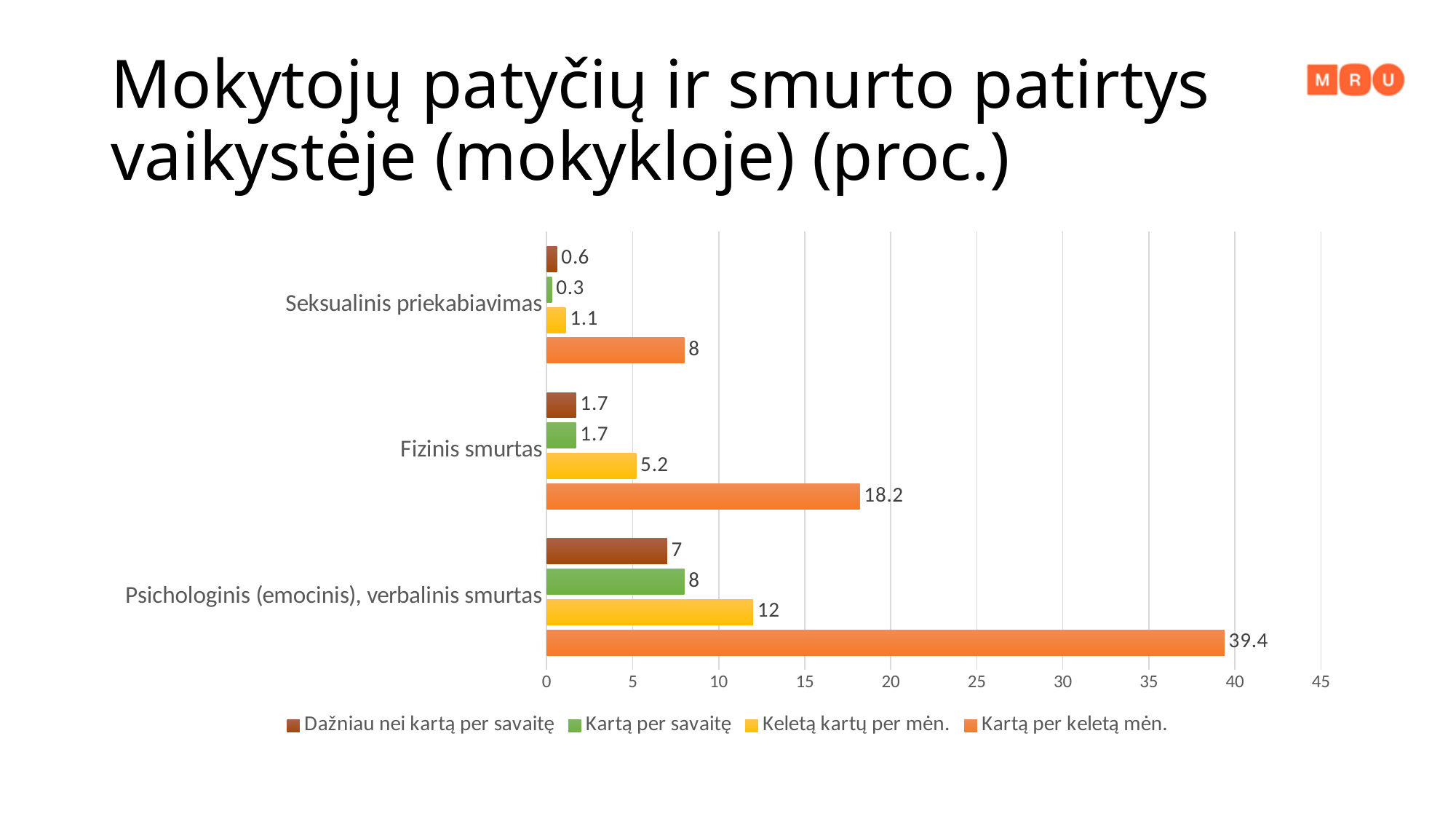
What kind of chart is shown on the slide? bar chart Which is larger: the "Keletą kartų per mėn." value for "Fizinis smurtas" or the "Kartą per keletą mėn." value for "Seksualinis priekabiavimas"? Kartą per keletą mėn. for Seksualinis priekabiavimas Which category has the lowest value for "Kartą per savaitę"? Seksualinis priekabiavimas Is the "Kartą per keletą mėn." value for "Fizinis smurtas" greater or less than 20? less What is the difference between the "Kartą per keletą mėn." values for "Psichologinis (emocinis), verbalinis smurtas" and "Fizinis smurtas"? 21.2 What is the value for "Dažniau nei kartą per savaitę" in the "Psichologinis (emocinis), verbalinis smurtas" category? 7 How many series does the legend list? 4 What is the value for "Kartą per keletą mėn." in the "Psichologinis (emocinis), verbalinis smurtas" category? 39.4 Which category has the highest value for "Kartą per keletą mėn."? Psichologinis (emocinis), verbalinis smurtas What is the value for "Keletą kartų per mėn." in the "Fizinis smurtas" category? 5.2 What is the value for "Kartą per savaitę" in the "Seksualinis priekabiavimas" category? 0.3 How many categories are shown on the chart? 3